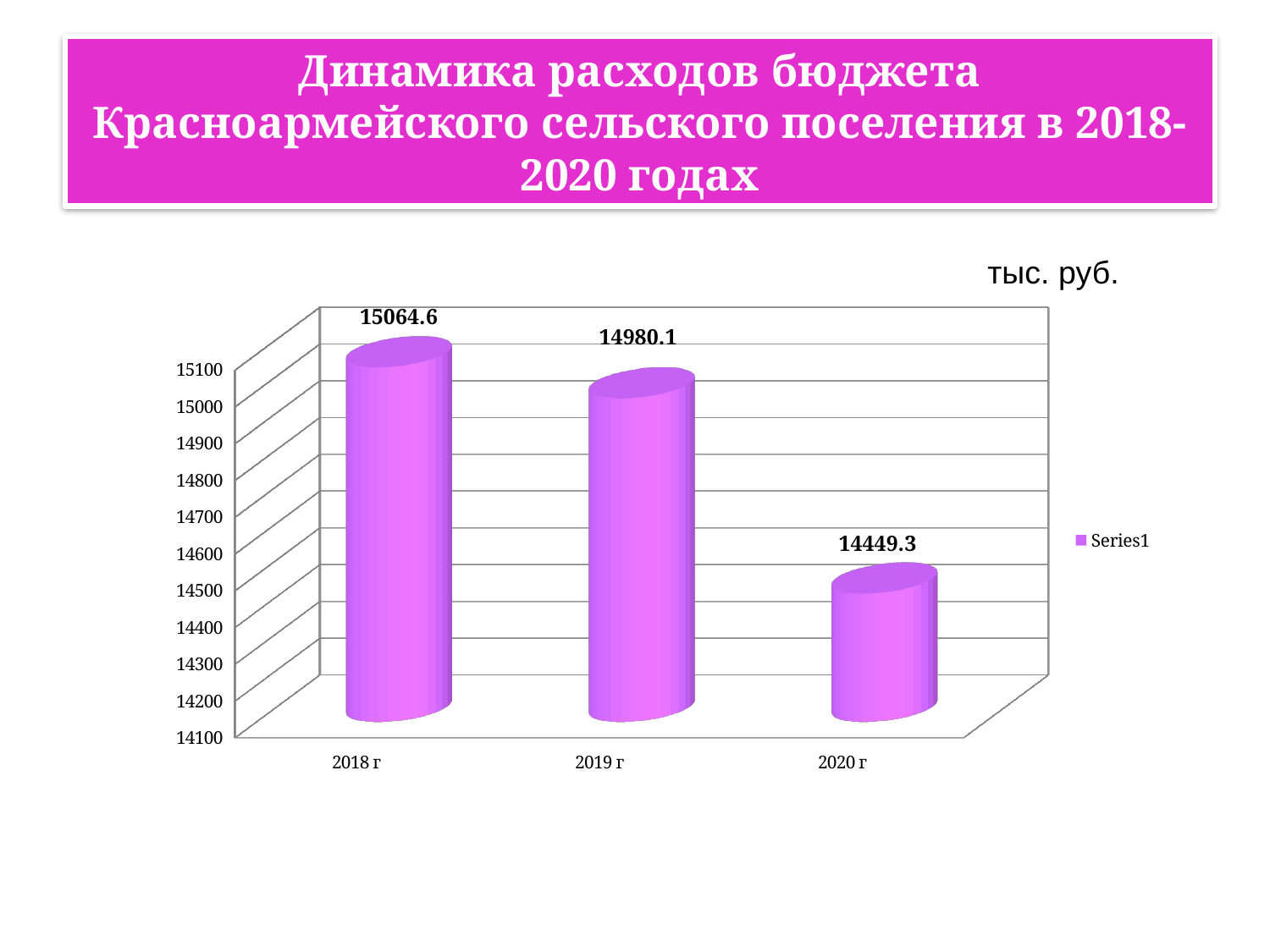
Which year has the highest value? 2018 г Which is larger, the value for 2019 г or the value for 2020 г? 2019 г How many categories are shown on the x axis? 3 What is the value for 2019 г? 14980.1 What is the difference between the values for 2018 г and 2020 г? 615.3 What is the difference between the values for 2018 г and 2019 г? 84.5 Do the values rise or fall from 2018 г to 2020 г? fall Which year has the lowest value? 2020 г Is the value for 2020 г greater or less than 14500? less What is the value for 2018 г? 15064.6 What is the value for 2020 г? 14449.3 What kind of chart is shown on the slide? bar chart